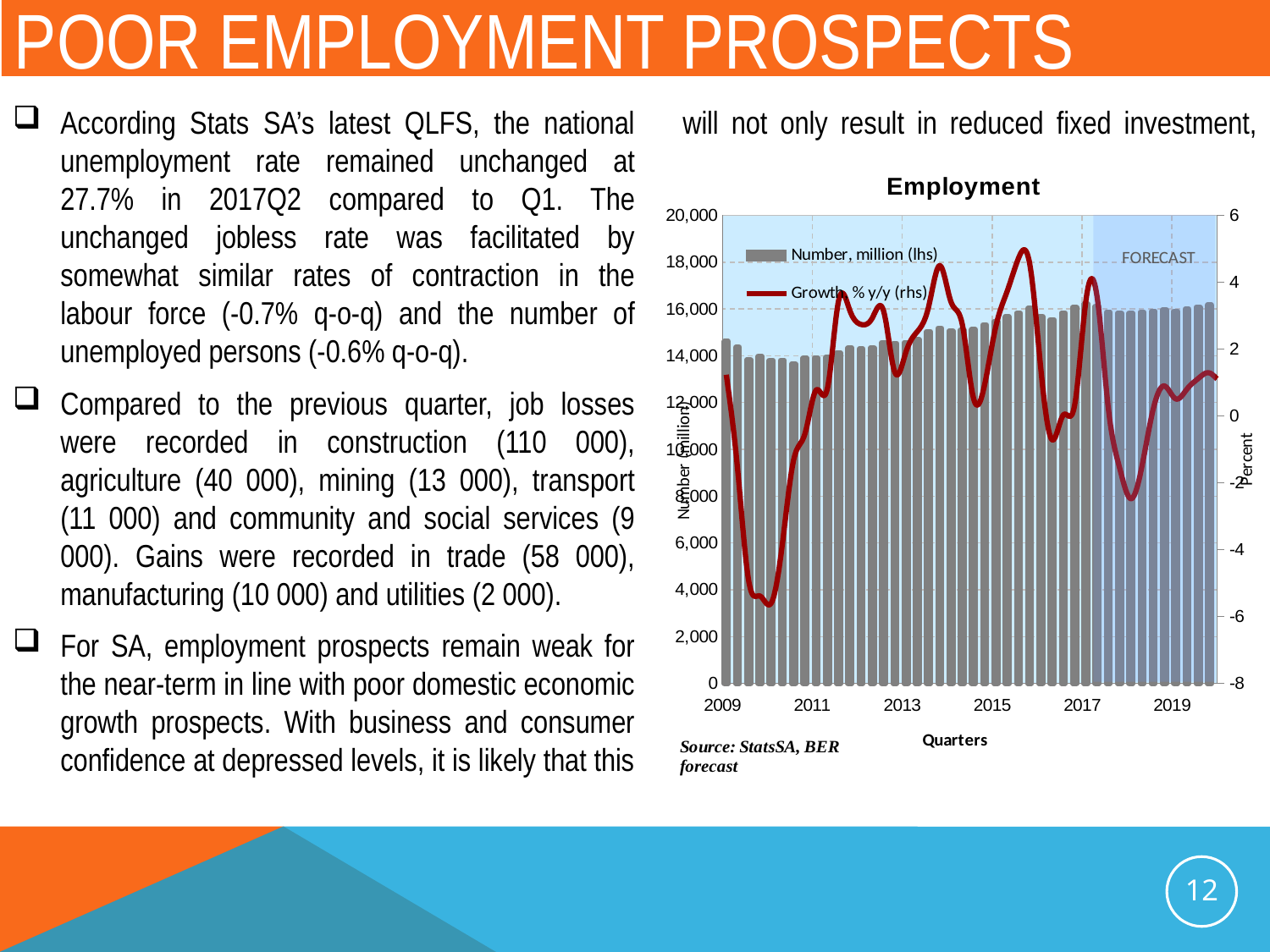
How many series does the chart's legend list? 2 Does the Growth, % y/y line rise or fall from the start of 2009 to its low point in 2010? fall Is the value of the Number, million bar for the first quarter of 2009 greater or less than 14,000? greater What is the title of the chart? Employment Do the Number, million bars generally rise or fall from 2009 to 2019? rise Is the Growth, % y/y line at its highest point around 2015-2016 greater or less than 4? greater How many year labels are shown on the x axis of the chart? 6 Which series in the chart is plotted as bars? Number, million (lhs) Is the Growth, % y/y line at its low point in 2018 greater or less than 0? less What kind of chart is shown on the slide? A combined bar and line chart